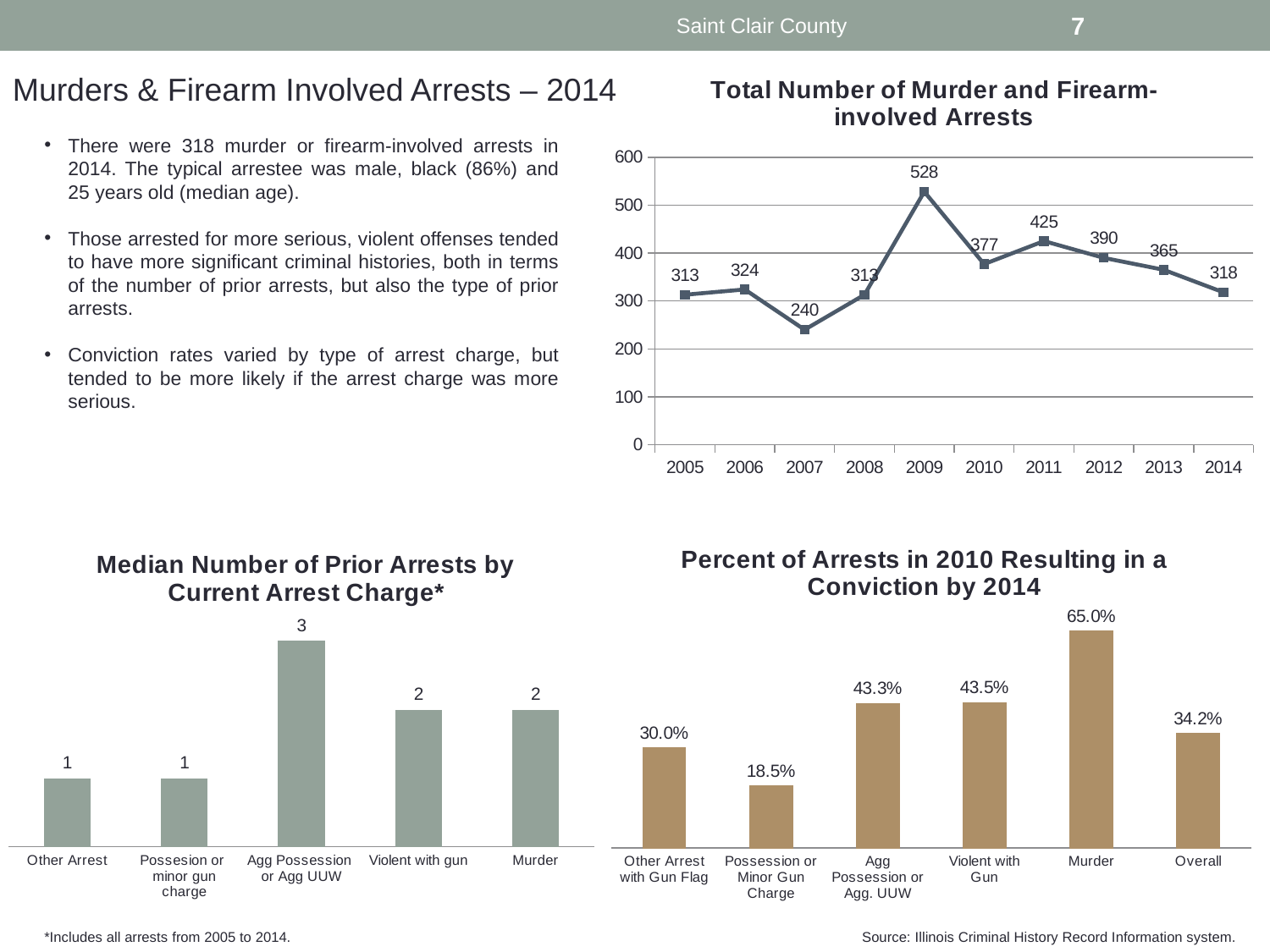
What type of chart is the 'Percent of Arrests in 2010 Resulting in a Conviction by 2014' chart? Bar chart In the 'Median Number of Prior Arrests by Current Arrest Charge*' chart, how many categories are shown? 5 In the 'Median Number of Prior Arrests by Current Arrest Charge*' chart, what is the value for Agg Possession or Agg UUW? 3 What type of chart is the 'Total Number of Murder and Firearm-involved Arrests' chart? Line chart In the 'Percent of Arrests in 2010 Resulting in a Conviction by 2014' chart, what is the value for Possession or Minor Gun Charge? 18.5% In the 'Total Number of Murder and Firearm-involved Arrests' chart, how many years are plotted? 10 In the 'Percent of Arrests in 2010 Resulting in a Conviction by 2014' chart, which category has the highest value? Murder In the 'Total Number of Murder and Firearm-involved Arrests' chart, do the values rise or fall from 2011 to 2014? Fall In the 'Total Number of Murder and Firearm-involved Arrests' chart, what is the difference between the 2009 value and the 2014 value? 210 In the 'Percent of Arrests in 2010 Resulting in a Conviction by 2014' chart, which is larger: Other Arrest with Gun Flag or Overall? Overall In the 'Total Number of Murder and Firearm-involved Arrests' chart, what was the value for 2009? 528 In the 'Total Number of Murder and Firearm-involved Arrests' chart, which year had the lowest number of arrests? 2007